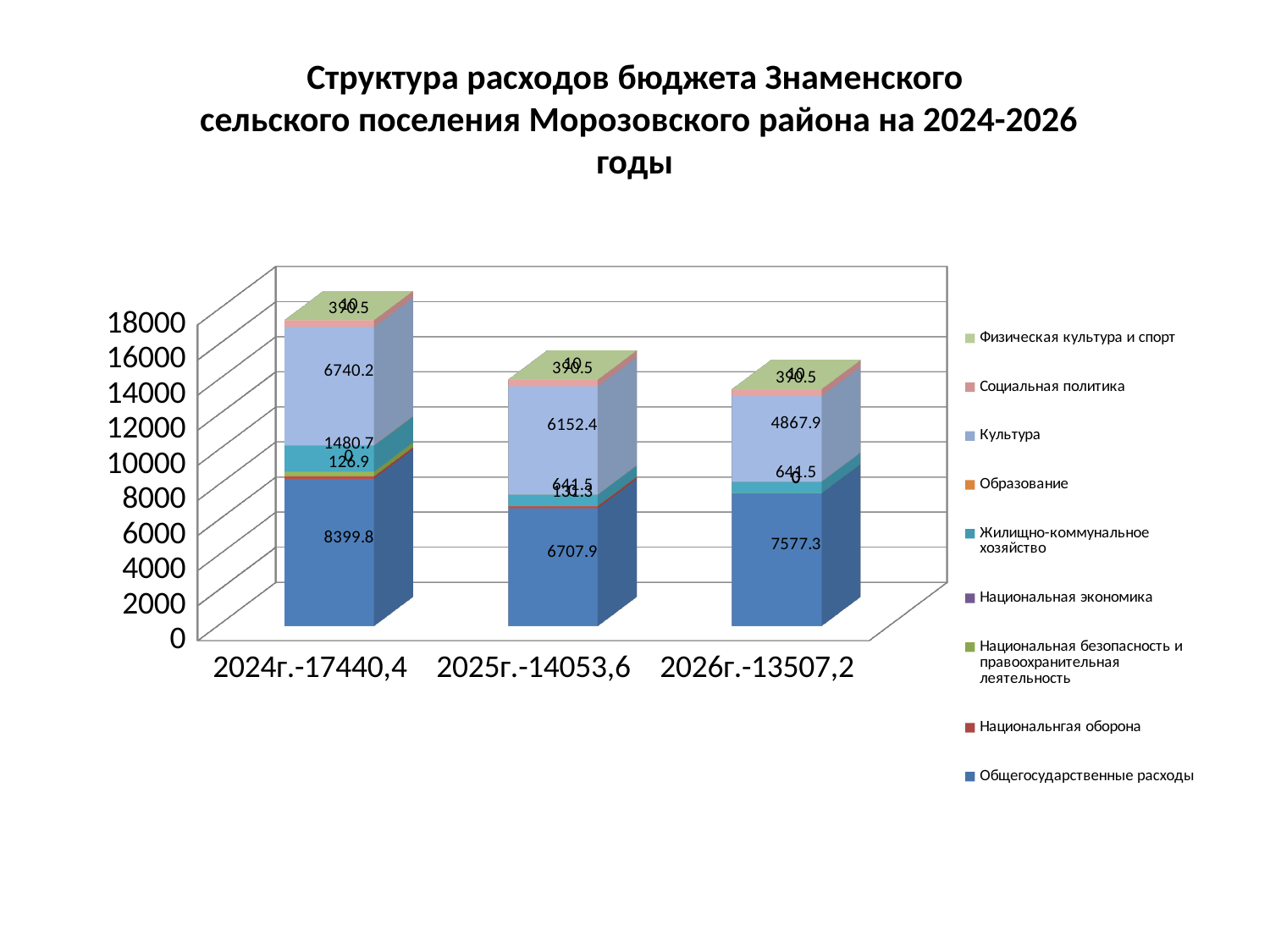
What is the value of Культура for 2025г.-14053,6? 6152.4 How many series does the legend list? 9 How many categories (years) are shown on the x axis? 3 What kind of chart is shown on the slide? Stacked bar chart What is the total of the stacked bar for 2024, as given in its category label? 17440,4 What is the value of Жилищно-коммунальное хозяйство for 2024г.-17440,4? 1480.7 Which year has the highest value for Общегосударственные расходы? 2024г.-17440,4 Do the Культура values rise or fall from 2024 to 2026? Fall What is the value of Общегосударственные расходы for 2024г.-17440,4? 8399.8 Which year has the lowest value for Культура? 2026г.-13507,2 Which is larger: Общегосударственные расходы for 2025г.-14053,6 or for 2026г.-13507,2? 2026г.-13507,2 What is the difference between the Культура values for 2024г.-17440,4 and 2026г.-13507,2? 1872.3